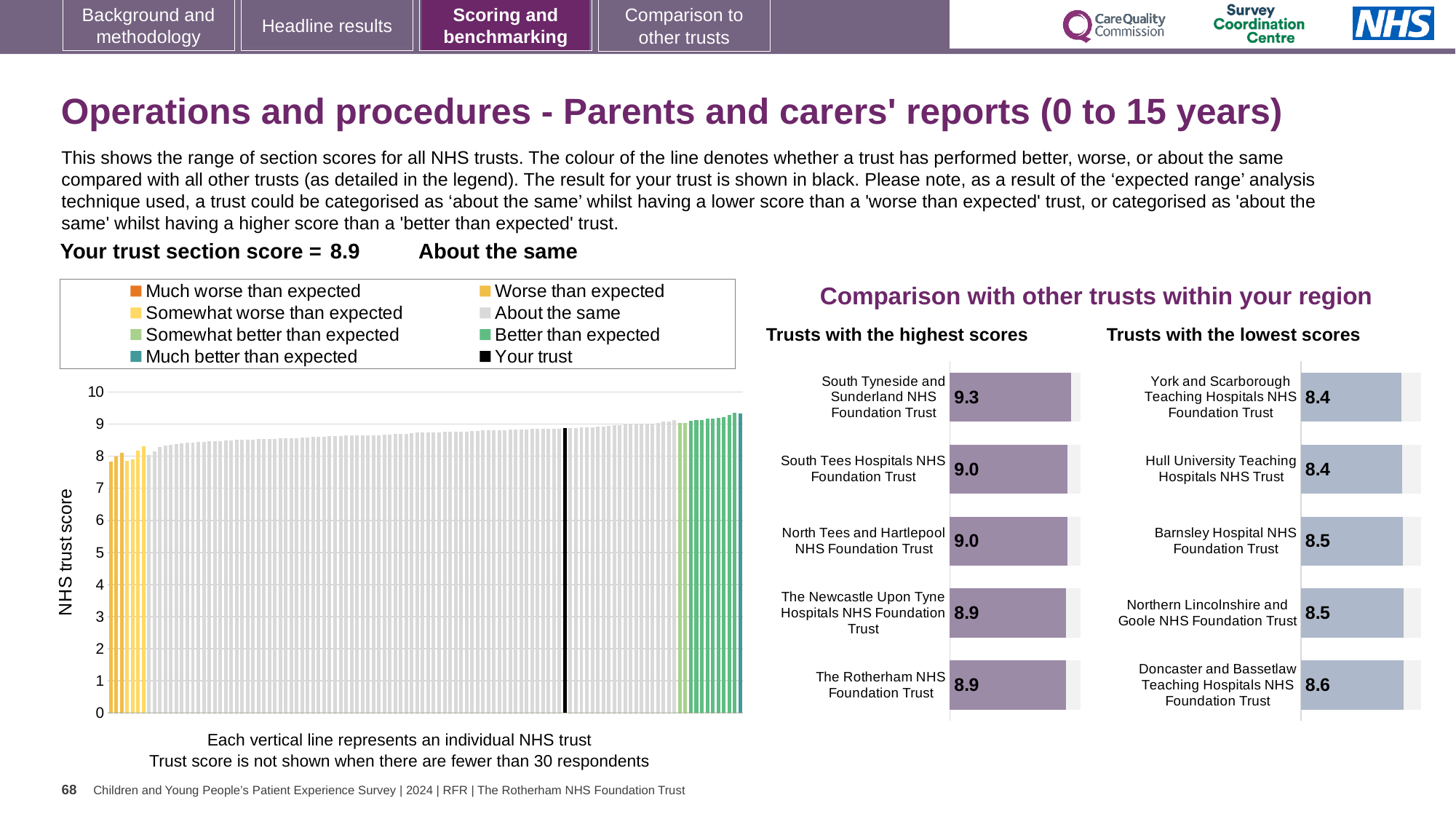
In the 'Trusts with the lowest scores' chart, what is the score for Barnsley Hospital NHS Foundation Trust? 8.5 What kind of chart is the main 'NHS trust score' chart on the left? Bar chart In the 'Trusts with the lowest scores' chart, what is the score for Doncaster and Bassetlaw Teaching Hospitals NHS Foundation Trust? 8.6 In the 'Trusts with the highest scores' chart, what is the difference between the scores of South Tyneside and Sunderland NHS Foundation Trust and The Rotherham NHS Foundation Trust? 0.4 In the main 'NHS trust score' chart on the left, do the trust scores rise or fall from left to right along the x axis? Rise In the 'Trusts with the lowest scores' chart, what is the difference between the scores of Doncaster and Bassetlaw Teaching Hospitals NHS Foundation Trust and York and Scarborough Teaching Hospitals NHS Foundation Trust? 0.2 In the 'Trusts with the lowest scores' chart, which is larger: the score for Hull University Teaching Hospitals NHS Trust or the score for Doncaster and Bassetlaw Teaching Hospitals NHS Foundation Trust? Doncaster and Bassetlaw Teaching Hospitals NHS Foundation Trust In the 'Trusts with the highest scores' chart, what is the score for South Tyneside and Sunderland NHS Foundation Trust? 9.3 In the main 'NHS trust score' chart on the left, what is the section score for your trust? 8.9 In the 'Trusts with the highest scores' chart, how many trusts are listed? 5 In the 'Trusts with the lowest scores' chart, which trust has the highest score shown? Doncaster and Bassetlaw Teaching Hospitals NHS Foundation Trust In the 'Trusts with the highest scores' chart, which trust has the highest score? South Tyneside and Sunderland NHS Foundation Trust